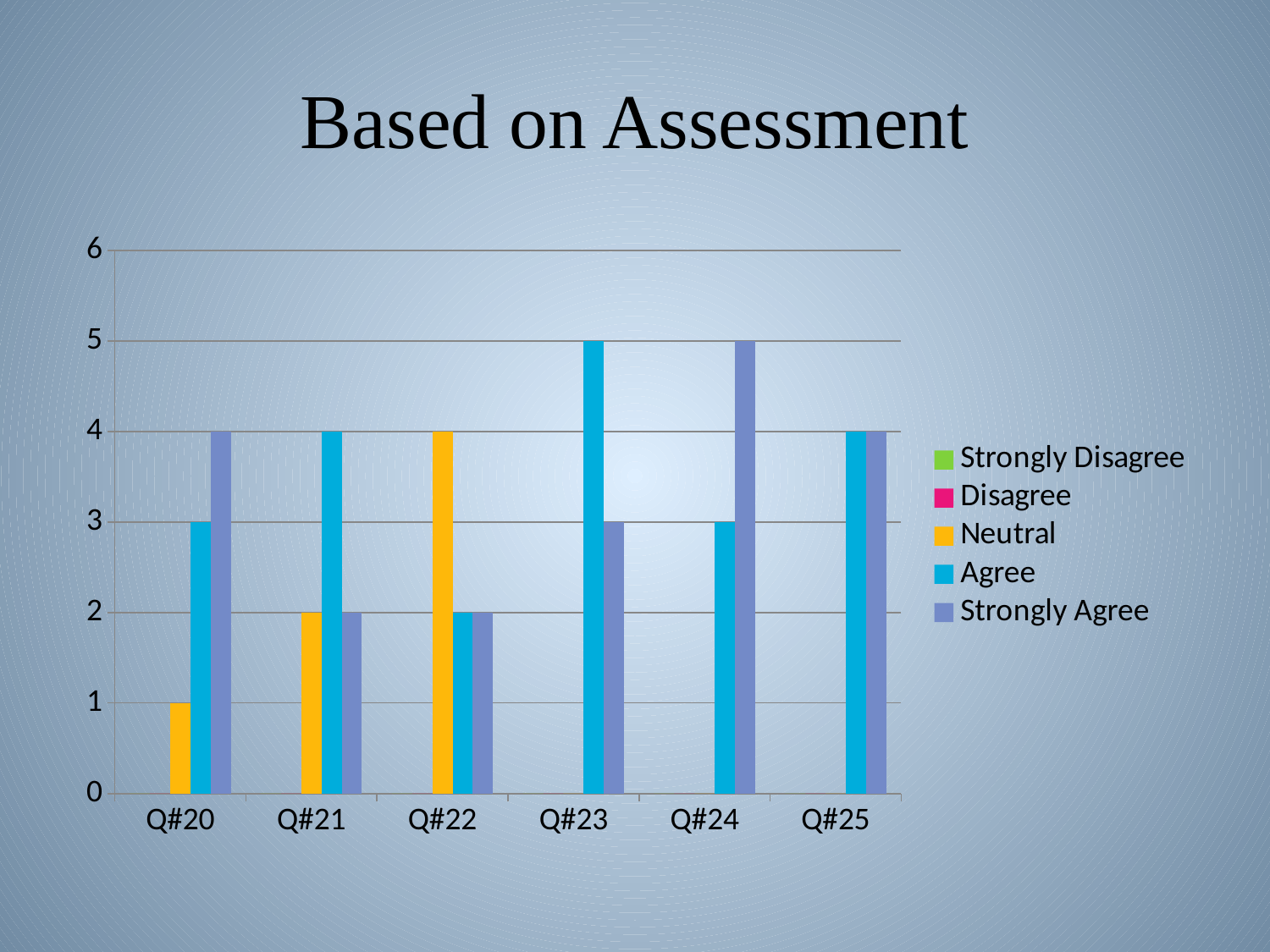
How many series does the legend list? 5 What is the Neutral value for Q#20? 1 How many question categories are shown on the x axis? 6 What is the Agree value for Q#23? 5 Which question has the highest Agree value? Q#23 What is the Neutral value for Q#22? 4 What is the title of the chart? Based on Assessment What kind of chart is shown on the slide? Bar chart Which question has the lowest Neutral value among those with a Neutral bar? Q#20 What is the Strongly Agree value for Q#24? 5 What is the difference between the Agree and Strongly Agree values for Q#20? 1 For Q#21, which is larger: the Agree value or the Strongly Agree value? Agree